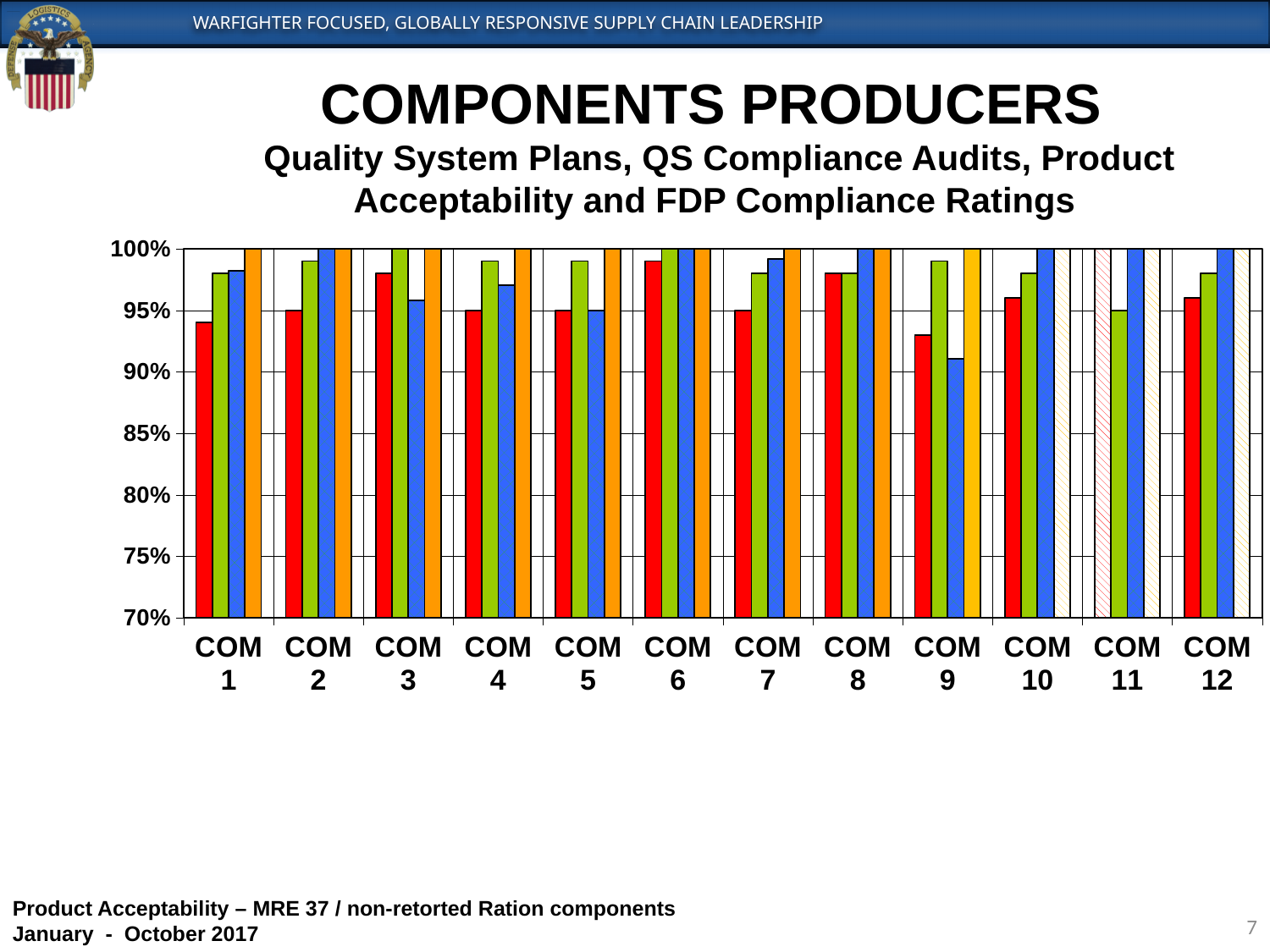
Which category has the lowest blue bar? COM 9 Is the blue bar for COM 9 greater or less than 95%? less Is the red bar for COM 9 greater or less than 95%? less Is the red bar for COM 3 greater or less than 95%? greater Which is larger, the red bar for COM 3 or the red bar for COM 9? COM 3 How many bars are plotted for each category? 4 What is the lowest value shown on the y axis? 70% How many component producer categories are shown on the x axis? 12 Which is larger, the blue bar for COM 2 or the blue bar for COM 9? COM 2 What kind of chart is shown on the slide? bar chart